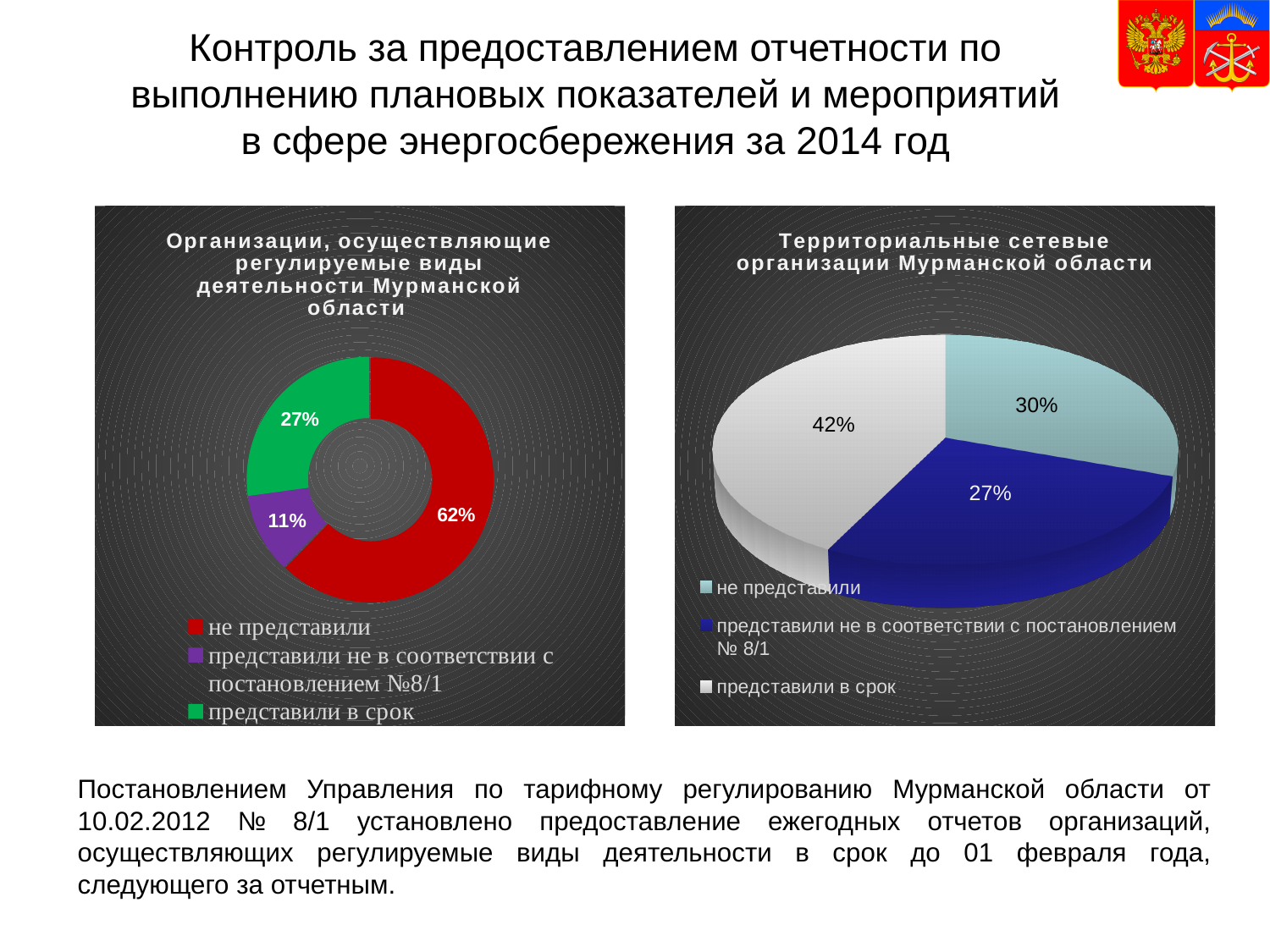
На диаграмме «Организации, осуществляющие регулируемые виды деятельности Мурманской области» какая категория имеет наименьшую долю? представили не в соответствии с постановлением №8/1 На диаграмме «Территориальные сетевые организации Мурманской области» какая доля организаций не представили отчетность? 30% На диаграмме «Территориальные сетевые организации Мурманской области» какая доля организаций представили отчетность в срок? 42% На диаграмме «Территориальные сетевые организации Мурманской области» какая доля больше: «не представили» или «представили не в соответствии с постановлением № 8/1»? не представили На диаграмме «Территориальные сетевые организации Мурманской области» какая категория имеет наибольшую долю? представили в срок На диаграмме «Организации, осуществляющие регулируемые виды деятельности Мурманской области» какая доля организаций не представили отчетность? 62% На диаграмме «Организации, осуществляющие регулируемые виды деятельности Мурманской области» на сколько процентных пунктов доля «не представили» больше доли «представили в срок»? 35 На диаграмме «Организации, осуществляющие регулируемые виды деятельности Мурманской области» какая доля организаций представили отчетность не в соответствии с постановлением №8/1? 11% Каким цветом на диаграмме «Организации, осуществляющие регулируемые виды деятельности Мурманской области» обозначена категория «не представили»? красным Сколько категорий показано на диаграмме «Территориальные сетевые организации Мурманской области»? 3 Какого типа диаграмма «Организации, осуществляющие регулируемые виды деятельности Мурманской области»? кольцевая диаграмма На диаграмме «Организации, осуществляющие регулируемые виды деятельности Мурманской области» какая доля организаций представили отчетность в срок? 27%